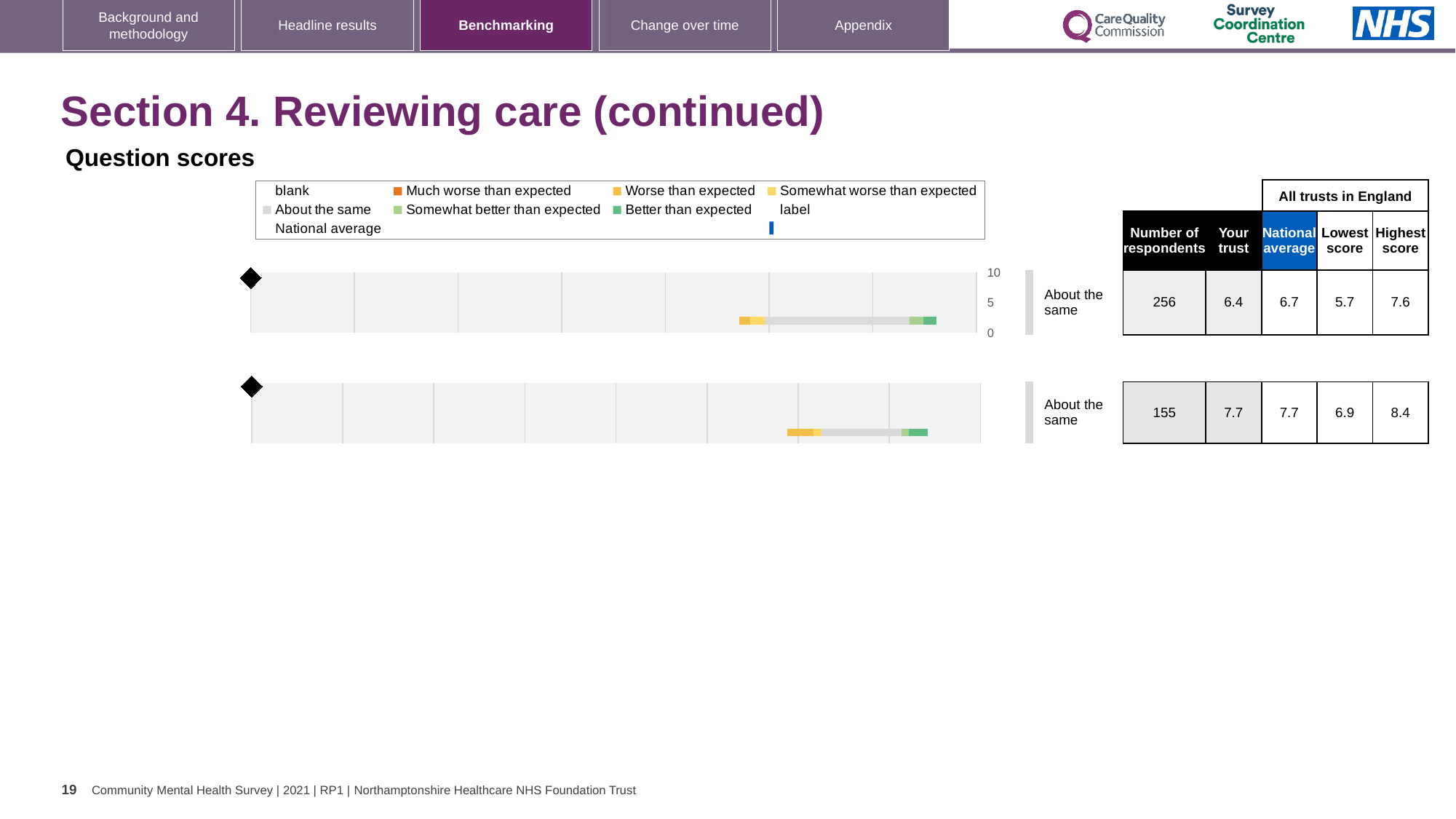
For the bottom chart's row, what is the difference between the highest score (8.4) and the lowest score (6.9)? 1.5 In the legend, what colour represents "Better than expected"? green For the bottom chart's row in the table, what is the highest score among all trusts in England? 8.4 For the bottom chart's row in the table, what is the lowest score among all trusts in England? 6.9 For the top chart's row in the table, what is the "Your trust" score? 6.4 What benchmark category label is shown next to the top chart? About the same For the top chart's row in the table, what is the number of respondents? 256 For the top chart's row in the table, what is the national average? 6.7 In the legend, what colour represents "Much worse than expected"? orange How many benchmark bar charts are shown on the slide? 2 What kind of chart is the top chart on the slide? bar chart For the top chart's row, which is larger: the "Your trust" score or the national average? National average